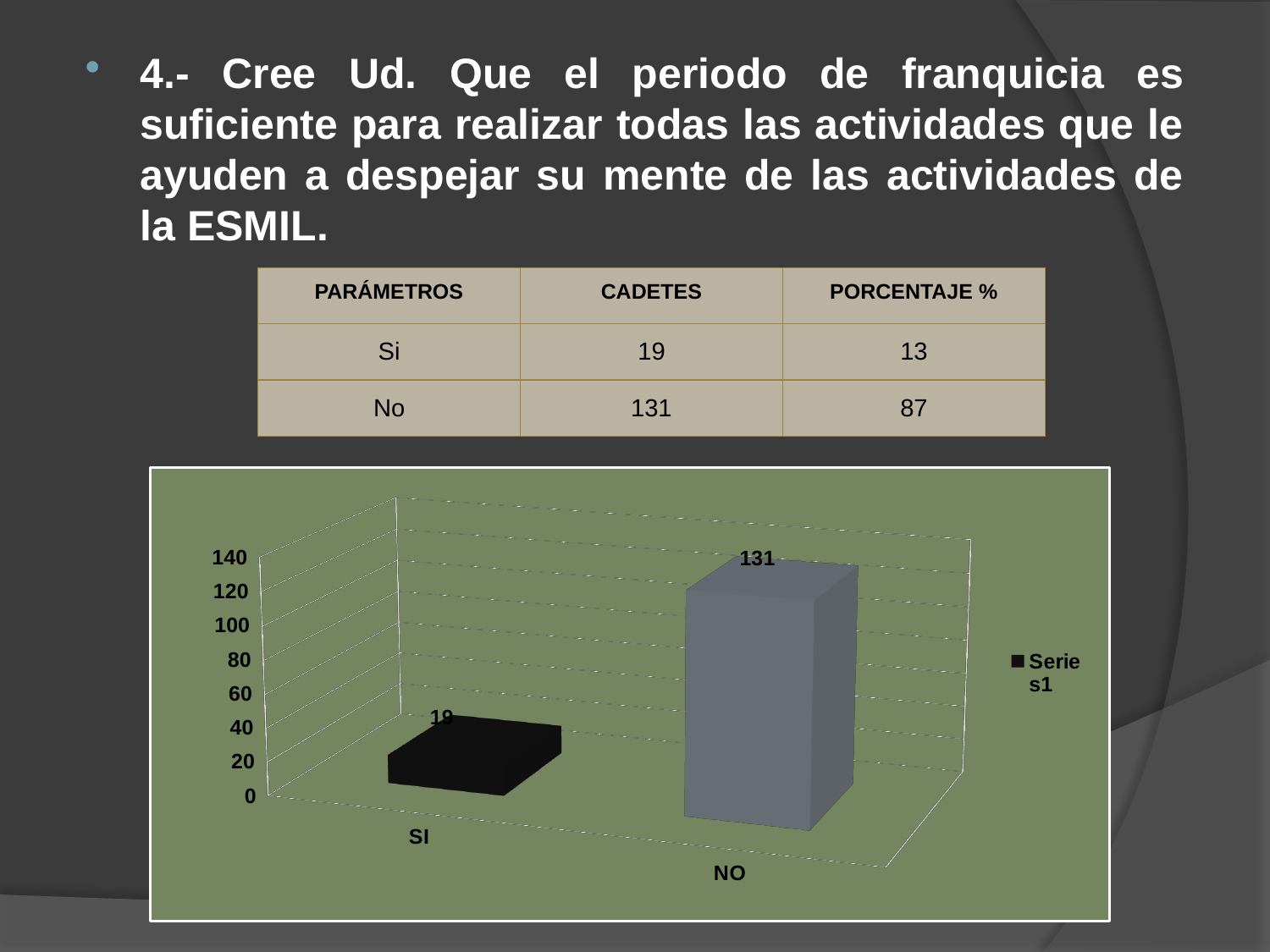
What is the difference between the values for NO and SI in the chart? 112 Is the value for NO greater or less than 100? greater How many categories are shown in the chart? 2 What kind of chart is shown on the slide? bar chart Which category has the lowest value in the chart? SI How many series does the chart legend list? 1 Which is larger in the chart, the value for SI or the value for NO? NO What is the value for NO in the chart? 131 What is the value for SI in the chart? 19 What is the name of the series shown in the chart legend? Series1 Is the value for SI greater or less than 40? less Which category has the highest value in the chart? NO